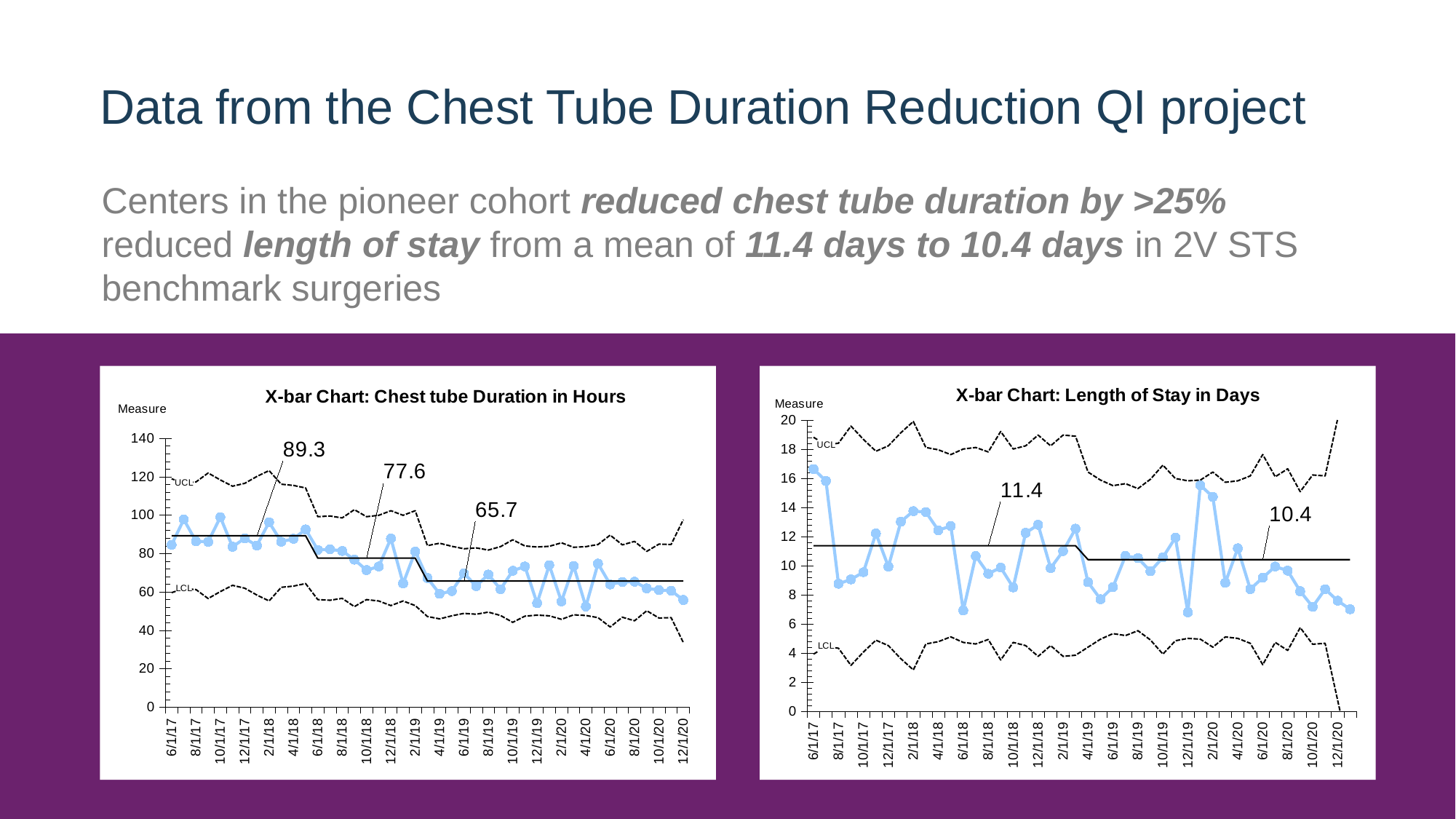
On the X-bar Chart: Chest tube Duration in Hours, what is the value of the final (rightmost) center line segment? 65.7 What label is shown on the vertical axis of both charts? Measure On the X-bar Chart: Chest tube Duration in Hours, what is the value of the middle center line segment? 77.6 On the X-bar Chart: Chest tube Duration in Hours, does the center line rise or fall from 6/1/17 to 12/1/20? Fall On the X-bar Chart: Length of Stay in Days, what is the value of the first center line segment? 11.4 On the X-bar Chart: Length of Stay in Days, is the plotted value for 6/1/17 greater or less than 14? greater On the X-bar Chart: Chest tube Duration in Hours, is the plotted value for 12/1/20 greater or less than 60? less On the X-bar Chart: Chest tube Duration in Hours, what is the difference between the first center line value and the final center line value? 23.6 On the X-bar Chart: Length of Stay in Days, by how much did the center line drop from its first value to its final value? 1.0 On the X-bar Chart: Length of Stay in Days, what is the value of the final center line segment? 10.4 What kind of chart is the X-bar Chart: Chest tube Duration in Hours? Line chart On the X-bar Chart: Chest tube Duration in Hours, what is the value of the first (leftmost) center line segment? 89.3